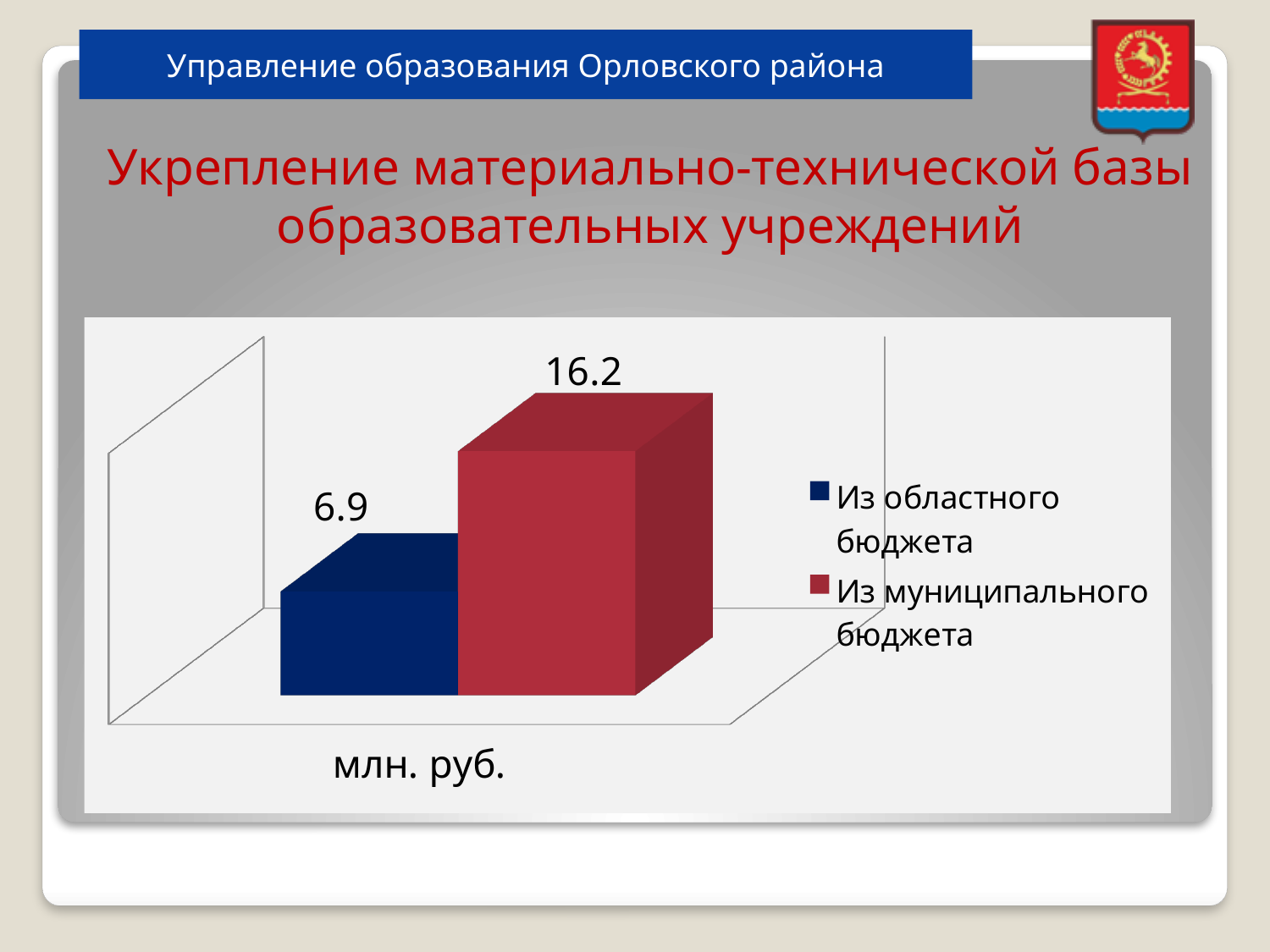
Which series has the highest value? Из муниципального бюджета What unit label is shown below the bars? млн. руб. How many bars are plotted on the chart? 2 Which is larger: the value for 'Из областного бюджета' or the value for 'Из муниципального бюджета'? Из муниципального бюджета What is the total of the two plotted values? 23.1 What is the value for 'Из областного бюджета'? 6.9 How many series does the legend list? 2 Which series has the lowest value? Из областного бюджета What is the value for 'Из муниципального бюджета'? 16.2 What kind of chart is shown on the slide? bar chart What colour is the bar for 'Из муниципального бюджета'? red What is the difference between the value for 'Из муниципального бюджета' and the value for 'Из областного бюджета'? 9.3